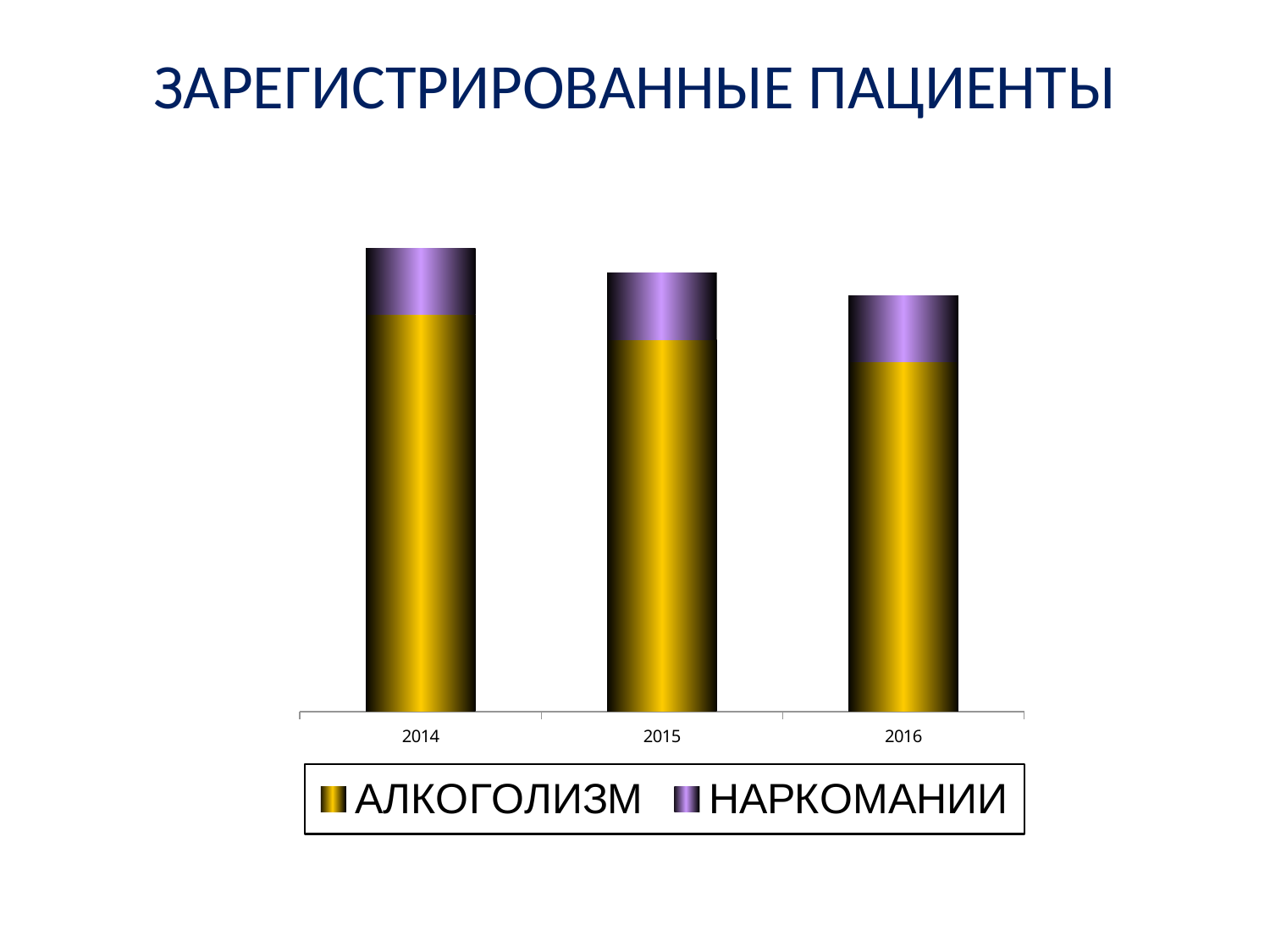
In 2015, which series has the larger segment, АЛКОГОЛИЗМ or НАРКОМАНИИ? АЛКОГОЛИЗМ Which series is shown in purple in the legend? НАРКОМАНИИ Which year has the tallest stacked bar overall? 2014 Which is larger, the АЛКОГОЛИЗМ segment in 2014 or in 2016? 2014 Which is larger, the total bar for 2015 or for 2016? 2015 How many years are shown on the x axis? 3 Which year has the shortest stacked bar overall? 2016 How many series does the legend list? 2 What kind of chart is shown on the slide? Stacked bar chart Do the total bar heights rise or fall from 2014 to 2016? Fall Which year has the smallest АЛКОГОЛИЗМ segment? 2016 What is the title of the chart? ЗАРЕГИСТРИРОВАННЫЕ ПАЦИЕНТЫ